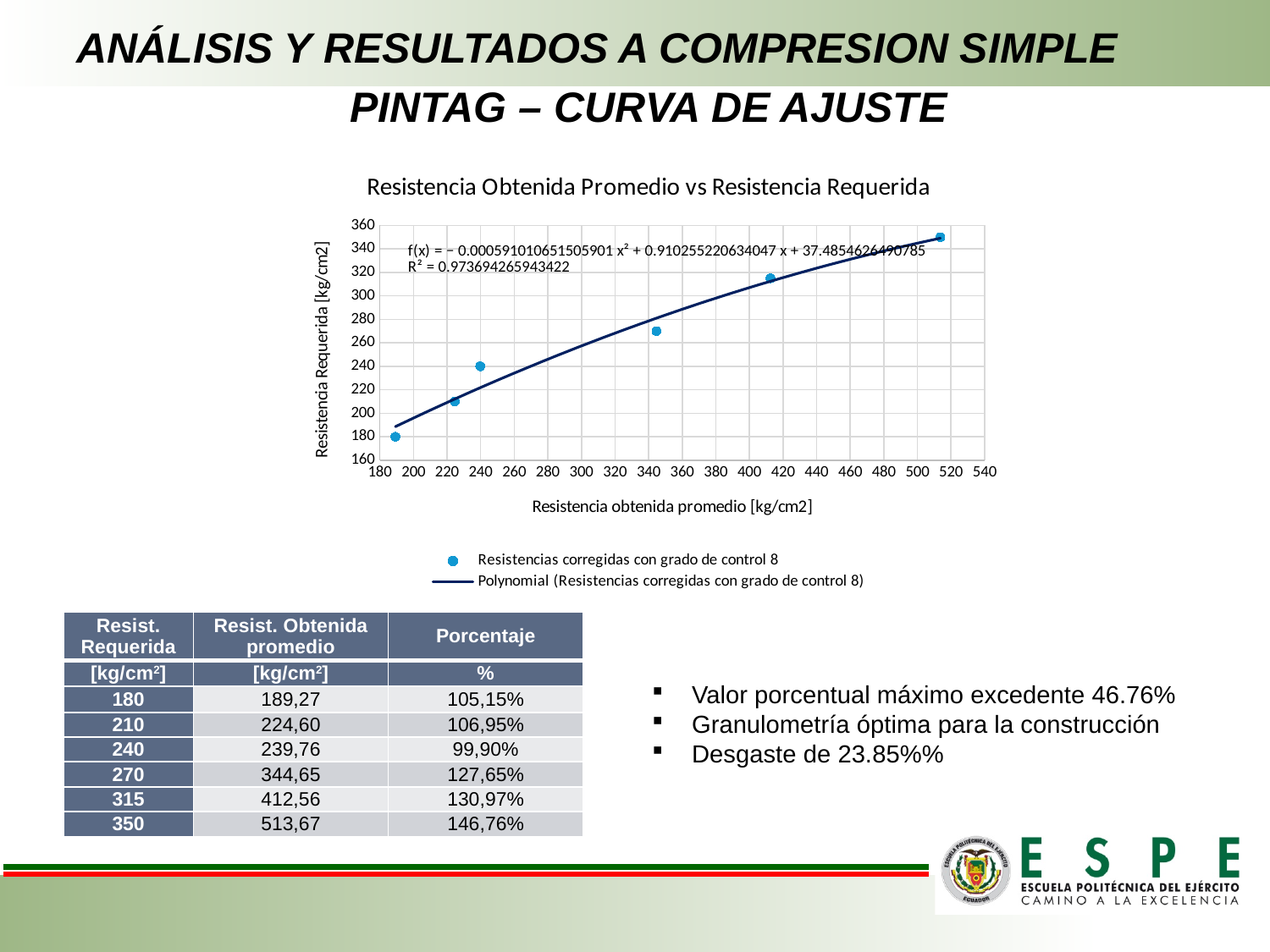
How many entries does the chart legend list? 2 Do the plotted values rise or fall as Resistencia obtenida promedio increases along the x axis? Rise What is the title of the chart? Resistencia Obtenida Promedio vs Resistencia Requerida Which data point has the highest Resistencia Requerida value? The rightmost point (Resist. Obtenida promedio 513,67) What are the minimum and maximum values shown on the y axis of the chart? 160 and 360 How many data points are plotted in the chart? 6 What is the label of the x axis of the chart? Resistencia obtenida promedio [kg/cm2] What kind of chart is shown on the slide? Scatter chart with a polynomial trendline Is the Resistencia Requerida value of the rightmost data point greater or less than 300? greater Is the Resistencia Requerida value of the data point near x = 345 greater or less than 300? less Is the Resistencia Requerida value of the leftmost data point greater or less than 200? less What is the R² value shown on the chart for the polynomial fit? 0.973694265943422